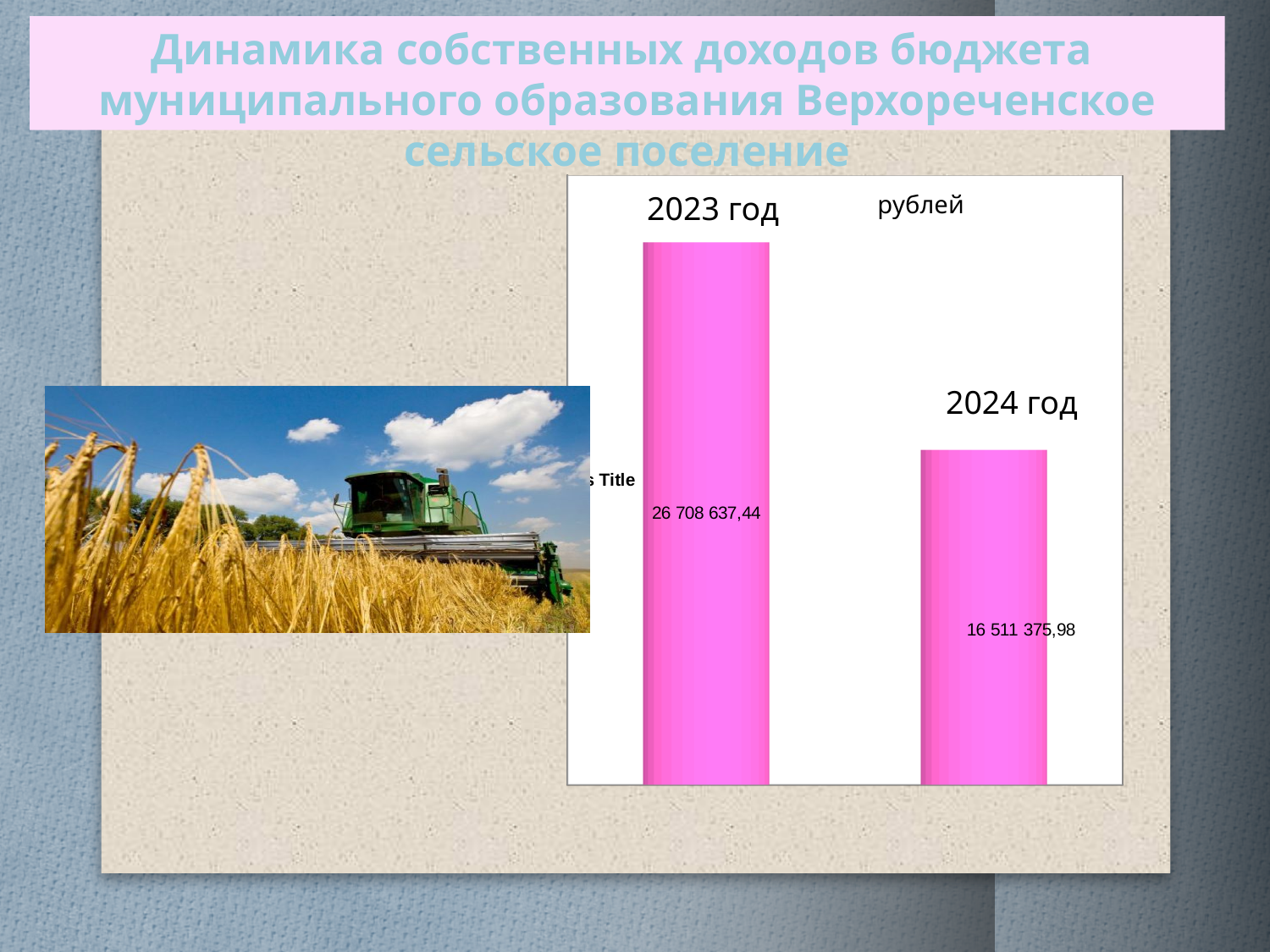
How many bars are plotted on the chart? 2 Which year has the lowest value on the chart? 2024 год What colour are the bars on the chart? pink What unit is indicated on the chart? рублей What is the value shown for 2023 год? 26 708 637,44 What is the difference between the values for 2023 год and 2024 год? 10 197 261,46 Which year has the higher value, 2023 год or 2024 год? 2023 год Do the values rise or fall from 2023 год to 2024 год? fall Which year has the highest value on the chart? 2023 год What kind of chart is shown on the slide? bar chart What is the value shown for 2024 год? 16 511 375,98